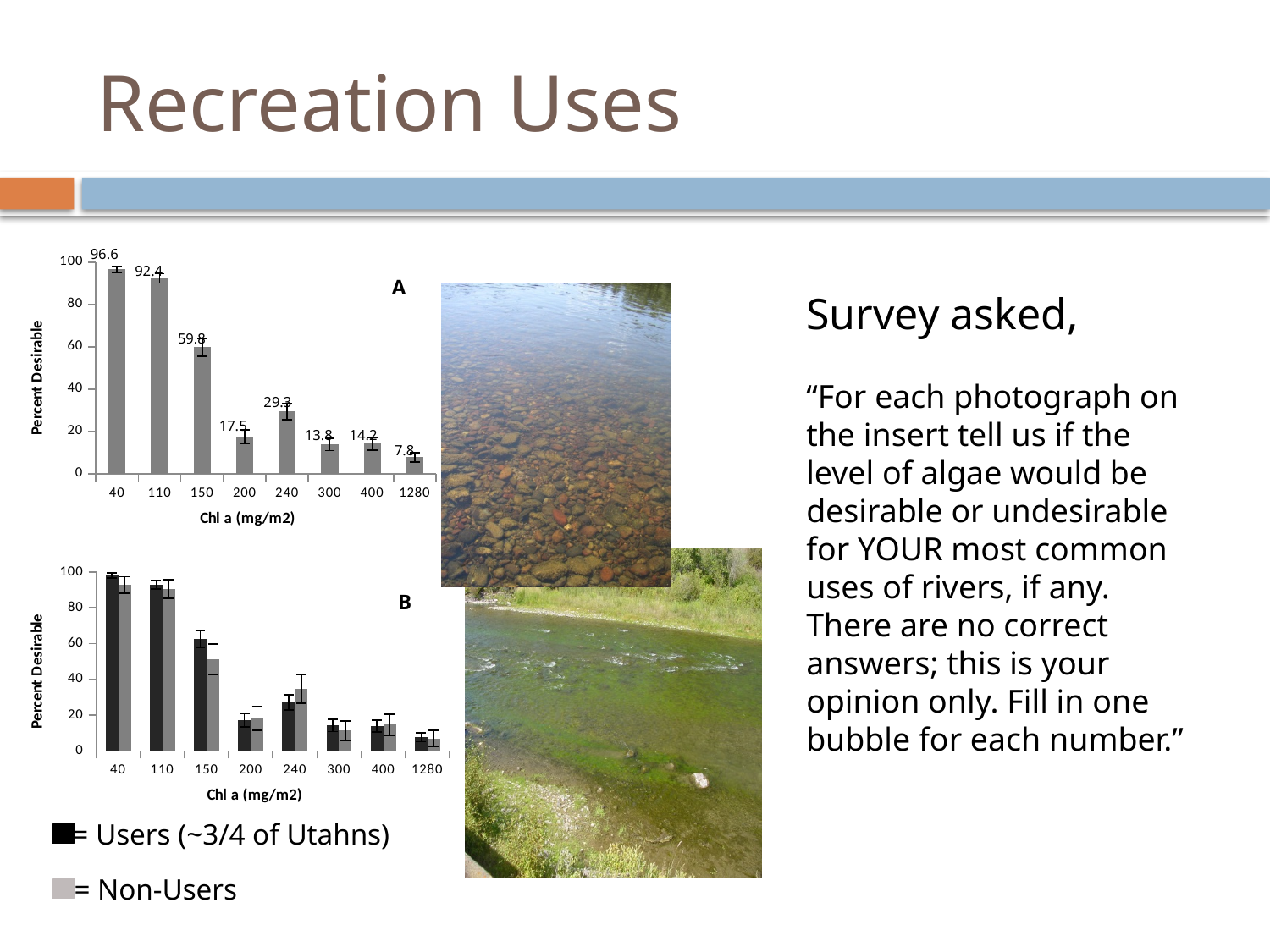
In chart B (bottom chart), how many series are shown according to the legend? 2 In chart A (top chart), what is the Percent Desirable value for Chl a of 150 mg/m2? 59.8 In chart A (top chart), how many Chl a categories are shown on the x axis? 8 In chart A (top chart), what is the difference in Percent Desirable between Chl a of 40 and Chl a of 110? 4.2 What type of chart is chart A (top chart)? Bar chart In chart A (top chart), what is the Percent Desirable value for Chl a of 40 mg/m2? 96.6 In chart A (top chart), which Chl a category has the highest Percent Desirable? 40 In chart B (bottom chart), is the Non-Users value for Chl a of 1280 mg/m2 greater or less than 20? less In chart A (top chart), what is the Percent Desirable value for Chl a of 1280 mg/m2? 7.8 In chart B (bottom chart), is the Users value for Chl a of 40 mg/m2 greater or less than 80? greater In chart A (top chart), which has a higher Percent Desirable: Chl a of 200 or Chl a of 240? 240 In chart A (top chart), which Chl a category has the lowest Percent Desirable? 1280